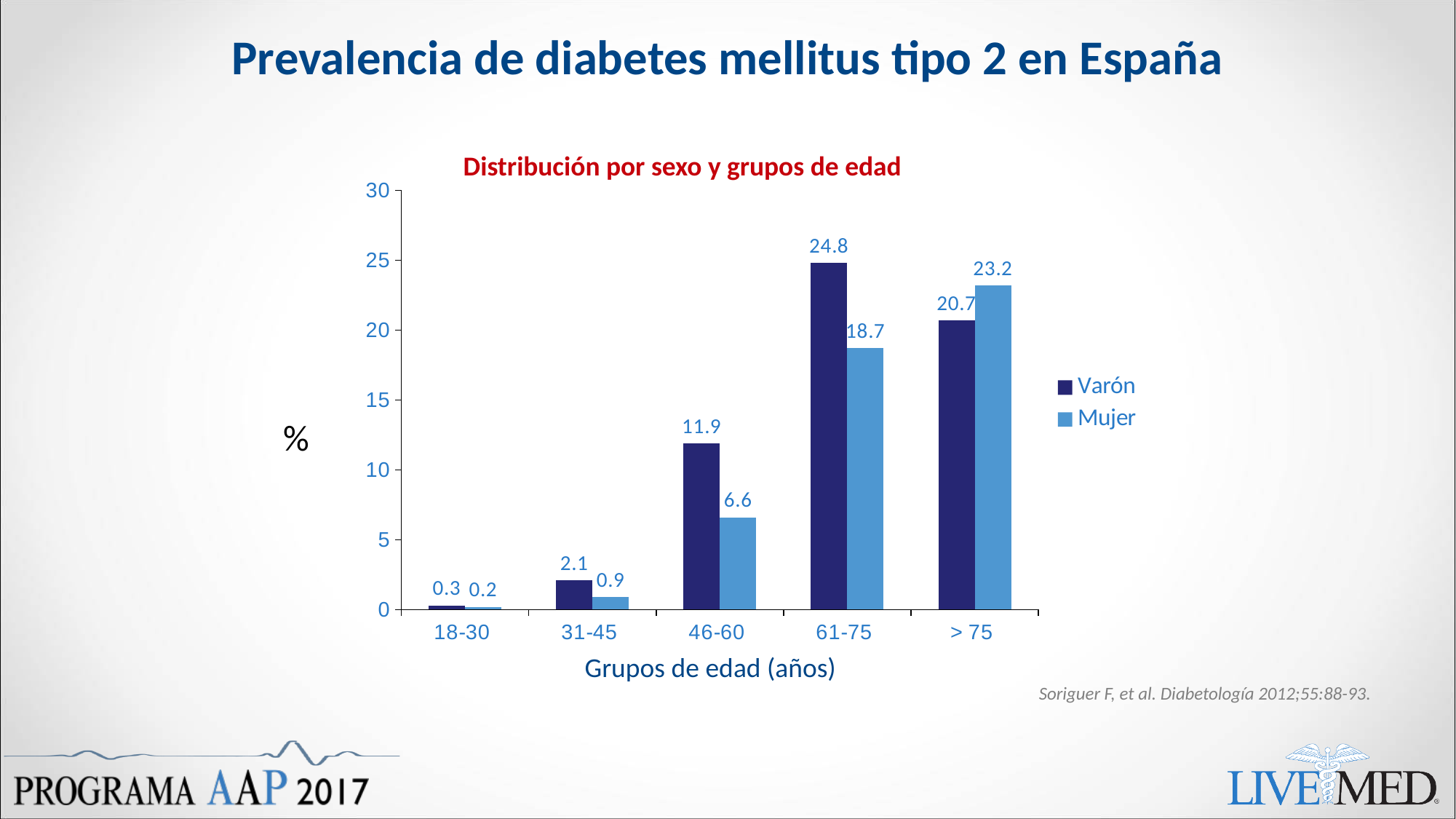
What is the difference between the Varón and Mujer values in the 61-75 age group? 6.1 What is the label of the x axis? Grupos de edad (años) What kind of chart is shown on the slide? Bar chart How many series does the legend list? 2 What is the value for Varón in the 61-75 age group? 24.8 What is the value for Mujer in the > 75 age group? 23.2 Which age group has the lowest value for Mujer? 18-30 Is the value for Varón in the 46-60 age group greater or less than 10? greater Which age group has the highest value for Varón? 61-75 How many age groups are shown on the x axis? 5 In the > 75 age group, which is larger, Varón or Mujer? Mujer What is the value for Mujer in the 46-60 age group? 6.6